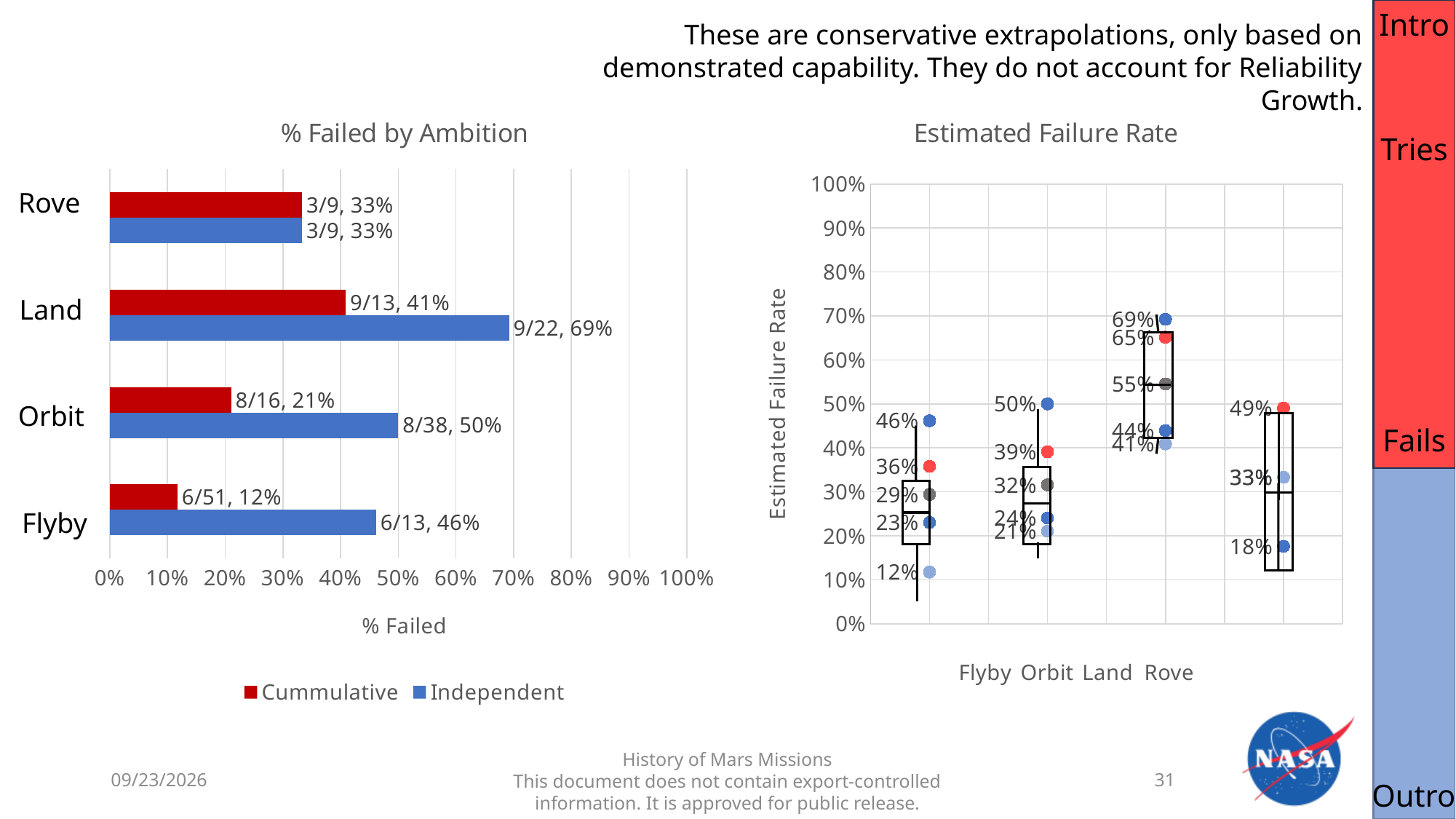
In the '% Failed by Ambition' chart, what is the difference in percentage points between the Independent and Cummulative values for Land? 28 In the '% Failed by Ambition' chart, what is the Cummulative value for Flyby? 6/51, 12% How many categories are shown in the '% Failed by Ambition' chart? 4 What kind of chart is the '% Failed by Ambition' chart on the left? bar chart How many series does the legend of the '% Failed by Ambition' chart list? 2 In the 'Estimated Failure Rate' chart, what is the highest labeled value for Rove? 49% In the '% Failed by Ambition' chart, which category has the highest Independent percentage? Land In the 'Estimated Failure Rate' chart, what is the lowest labeled value for Flyby? 12% In the '% Failed by Ambition' chart, what is the Independent value for Land? 9/22, 69% In the '% Failed by Ambition' chart, which category has the lowest Cummulative percentage? Flyby In the 'Estimated Failure Rate' chart, what is the highest labeled value for Land? 69% In the '% Failed by Ambition' chart, which is larger for Orbit, the Cummulative or the Independent value? Independent